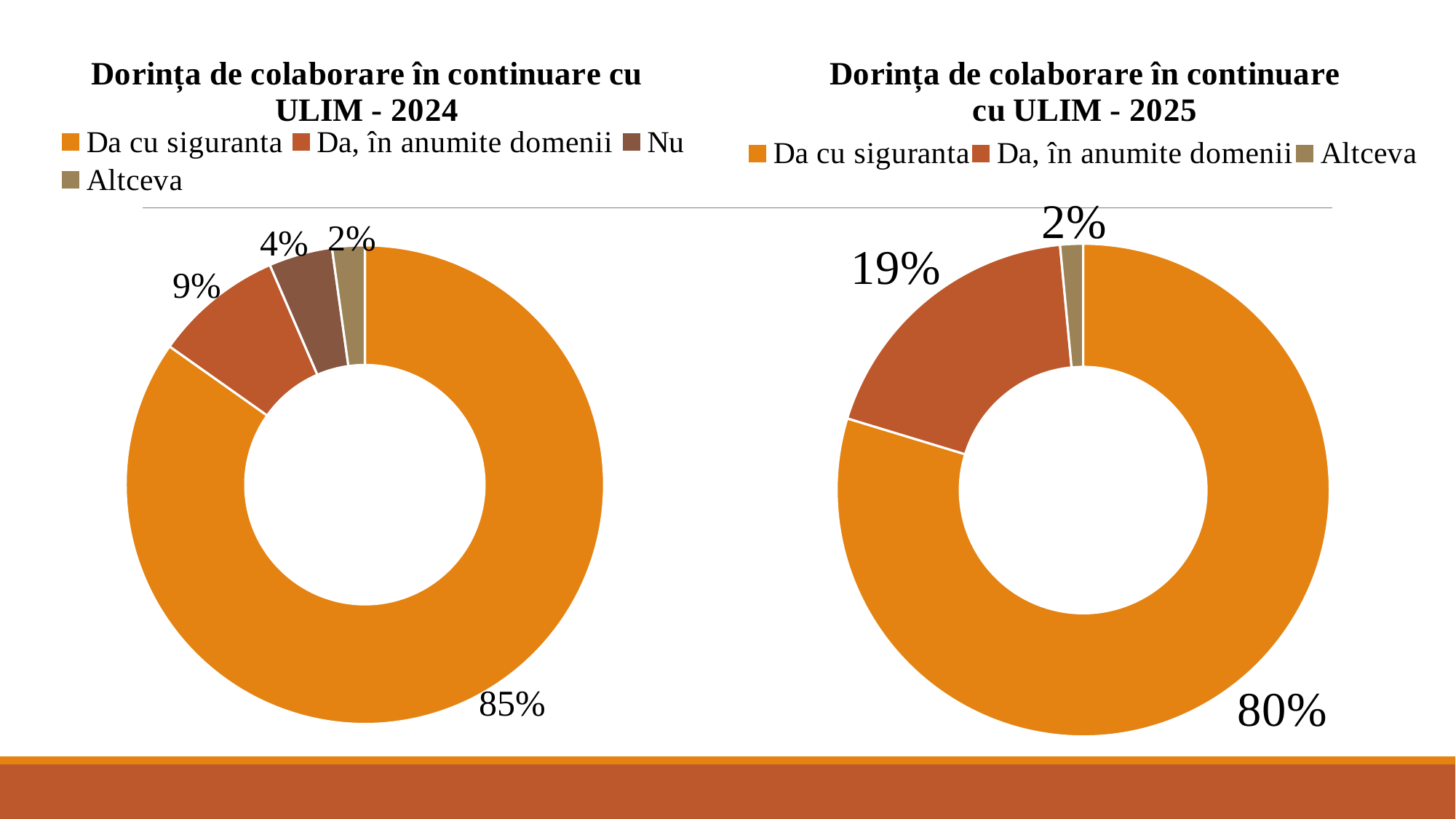
In the 2025 chart (right), what share is labelled for 'Da, în anumite domenii'? 19% What is the difference between the 'Da cu siguranta' share in the 2024 chart and in the 2025 chart? 5% Which chart shows a larger share for 'Da, în anumite domenii', the 2024 chart or the 2025 chart? 2025 chart In the 2025 chart (right), what share is labelled for 'Altceva'? 2% In the 2025 chart (right), what share is labelled for 'Da cu siguranta'? 80% In the 2024 chart (left), which category has the largest slice? Da cu siguranta In the 2024 chart (left), what share is labelled for 'Da, în anumite domenii'? 9% In the 2024 chart (left), what share is labelled for 'Nu'? 4% How many categories does the legend of the 2024 chart (left) list? 4 What type of chart is the 2025 chart (right)? Doughnut chart In the 2024 chart (left), what share is labelled for 'Da cu siguranta'? 85% In the 2025 chart (right), which category has the smallest slice? Altceva